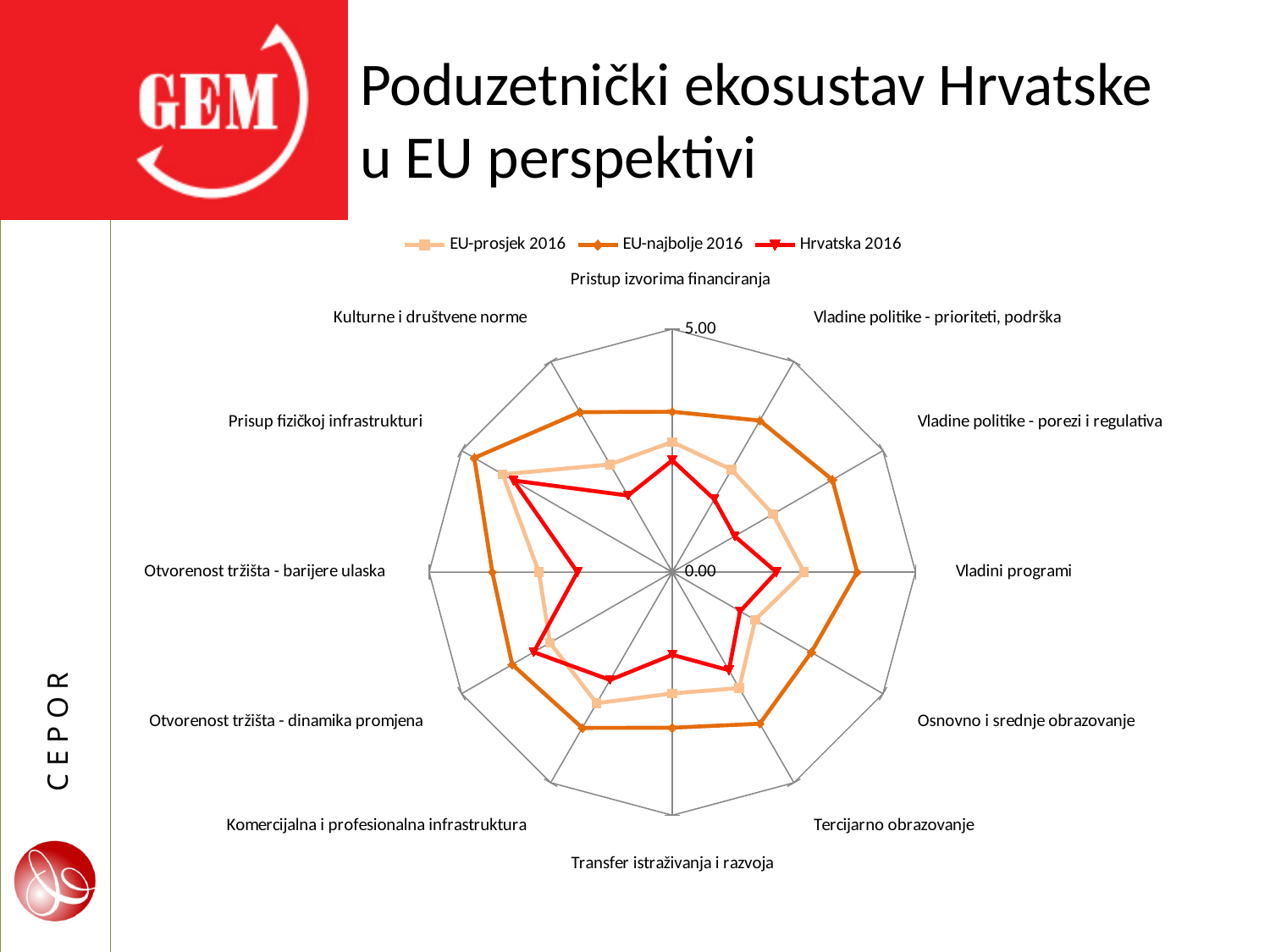
For which category does the Hrvatska 2016 series reach its highest value? Prisup fizičkoj infrastrukturi What is the maximum value shown on the radar chart's axis scale? 5.00 How many categories (axes) does the radar chart have? 12 For Osnovno i srednje obrazovanje, which series has the larger value: EU-najbolje 2016 or Hrvatska 2016? EU-najbolje 2016 Is the value for EU-najbolje 2016 on Vladini programi greater or less than 5.00? less Is the value for Hrvatska 2016 on Pristup izvorima financiranja greater or less than 5.00? less For Vladini programi, which series has the larger value: EU-prosjek 2016 or Hrvatska 2016? EU-prosjek 2016 What kind of chart is shown on the slide? Radar chart For the Hrvatska 2016 series, which category has the larger value: Prisup fizičkoj infrastrukturi or Otvorenost tržišta - barijere ulaska? Prisup fizičkoj infrastrukturi How many series does the legend list? 3 Which series does the legend list first? EU-prosjek 2016